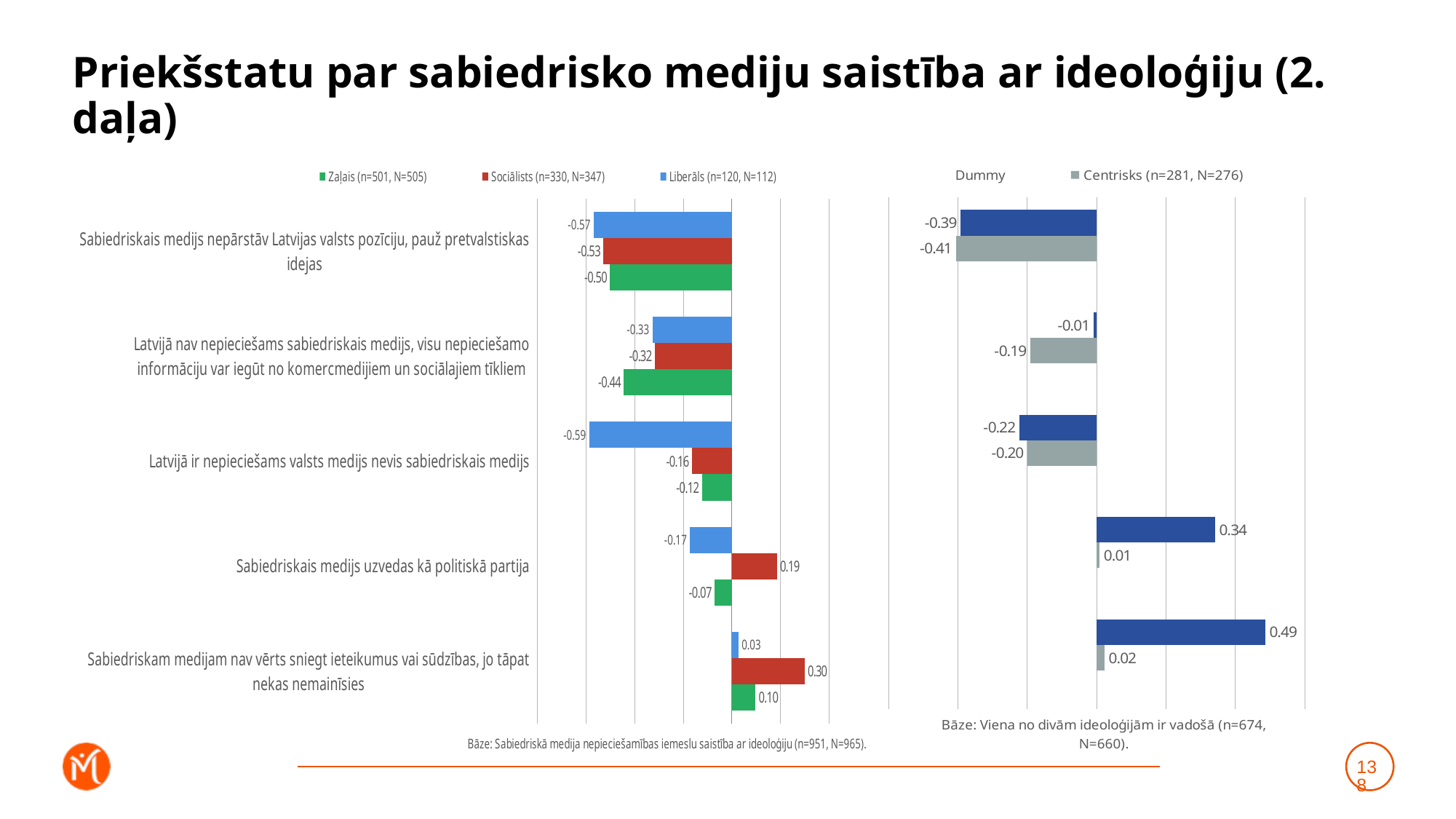
In the left chart, what is the Liberāls value for "Latvijā ir nepieciešams valsts medijs nevis sabiedriskais medijs"? -0.59 In the left chart, which is larger for "Sabiedriskais medijs nepārstāv Latvijas valsts pozīciju, pauž pretvalstiskas idejas": the Zaļais value or the Liberāls value? Zaļais In the left chart, which series has the lowest value for "Latvijā nav nepieciešams sabiedriskais medijs, visu nepieciešamo informāciju var iegūt no komercmedijiem un sociālajiem tīkliem"? Zaļais How many series does the legend of the left chart list? 3 What type of chart is the left chart? Bar chart In the left chart, what colour are the Sociālists bars? Red How many categories are shown in the right chart? 5 In the right chart, what is the Centrisks value for "Latvijā nav nepieciešams sabiedriskais medijs, visu nepieciešamo informāciju var iegūt no komercmedijiem un sociālajiem tīkliem"? -0.19 In the left chart, which series has the highest value for "Sabiedriskais medijs uzvedas kā politiskā partija"? Sociālists In the left chart, what is the Sociālists value for "Sabiedriskam medijam nav vērts sniegt ieteikumus vai sūdzības, jo tāpat nekas nemainīsies"? 0.30